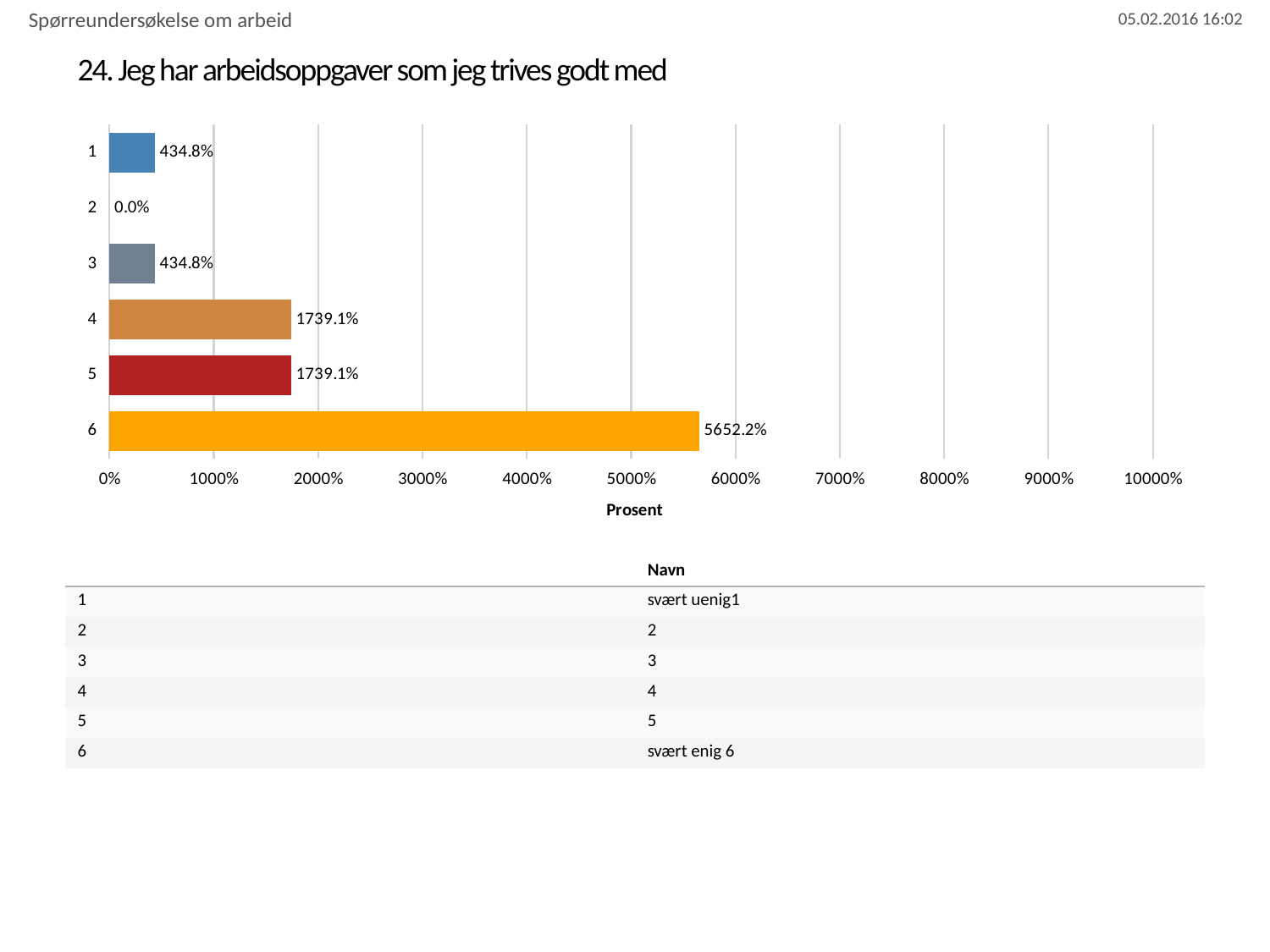
What is the value for category 6? 5652.2% What is the label of the horizontal axis? Prosent What is the value for category 2? 0.0% Is the value for category 6 greater or less than 5000%? greater Which category has the lowest value? 2 What is the difference between the values for category 6 and category 5? 3913.1% What is the value for category 4? 1739.1% How many categories are shown on the chart? 6 Which category has the highest value? 6 What is the difference between the values for category 4 and category 1? 1304.3% Which is larger, the value for category 3 or the value for category 5? category 5 What kind of chart is shown on the slide? bar chart